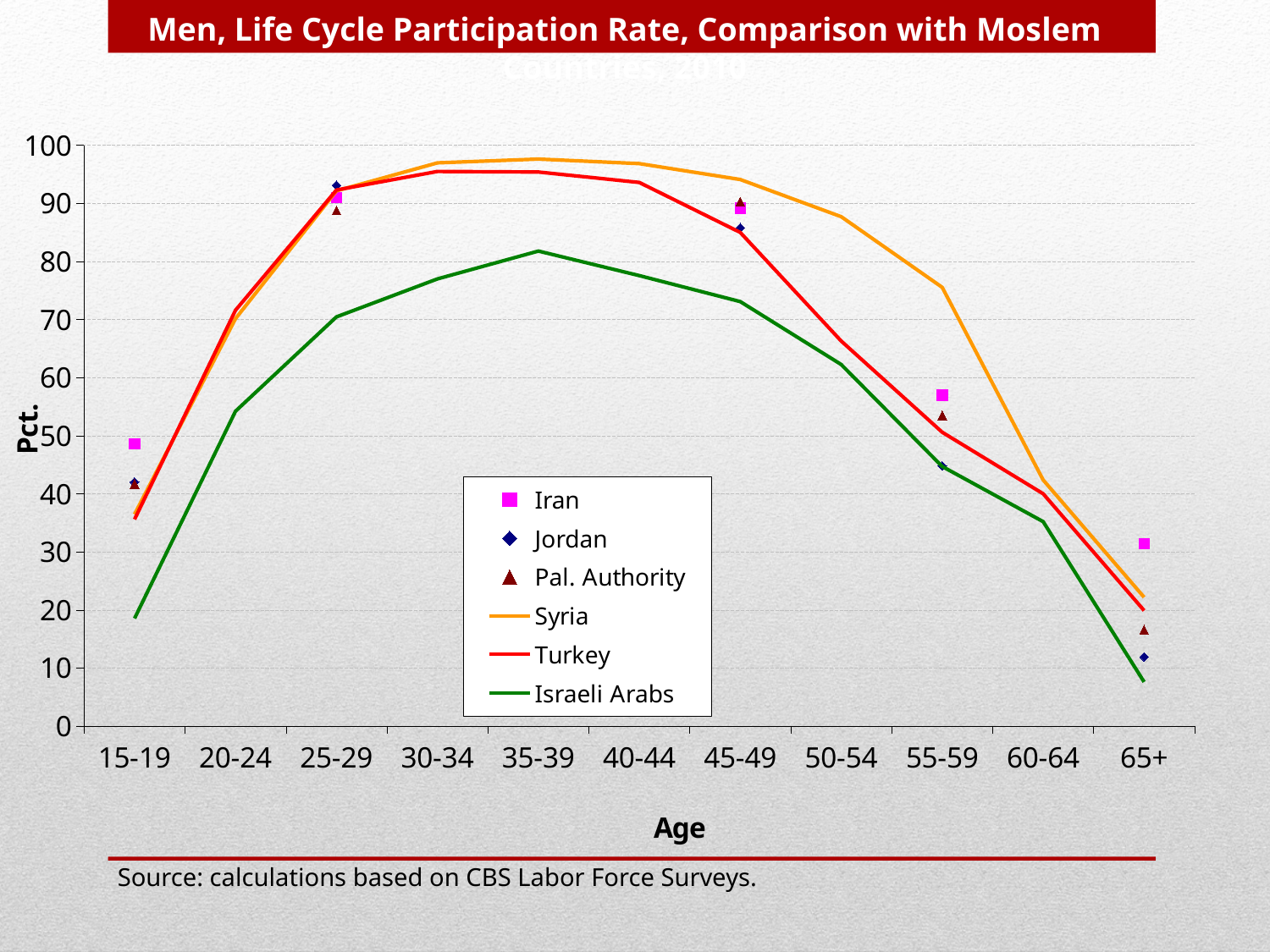
Is the value for Israeli Arabs at 35-39 greater or less than 80? greater What kind of chart is shown on the slide? line chart Does the Israeli Arabs line rise or fall from 35-39 to 65+? fall Is the value for Israeli Arabs at 65+ greater or less than 10? less At 45-49, which is higher: Syria or Israeli Arabs? Syria Is the value for Syria at 55-59 greater or less than 70? greater Which series is shown with a green line? Israeli Arabs What is the label of the y axis? Pct. How many series does the legend list? 6 At which age group does the Israeli Arabs line reach its lowest value? 65+ How many age groups are shown on the x axis? 11 At which age group does the Israeli Arabs line reach its highest value? 35-39